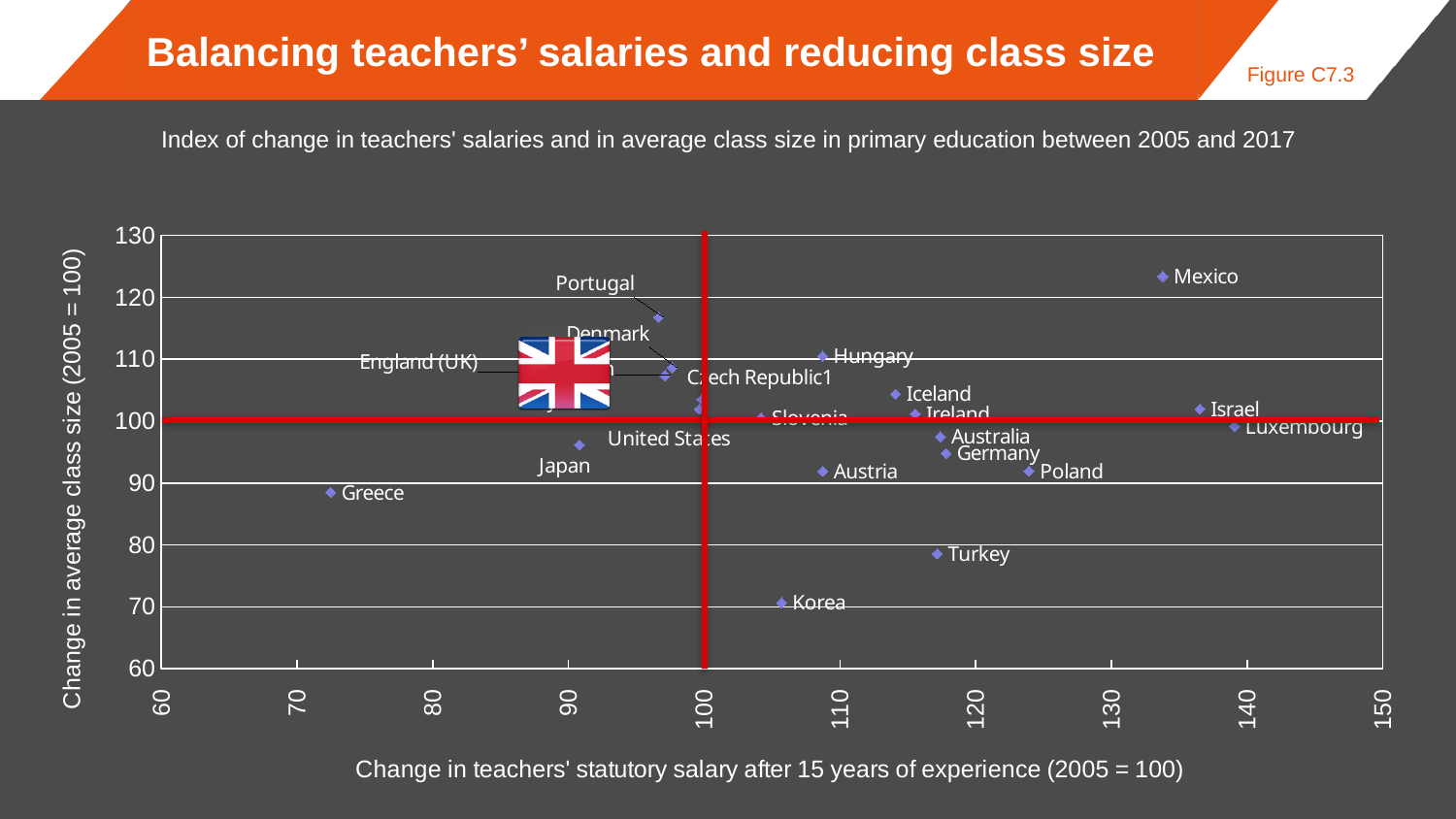
Which country has the lowest change in teachers' statutory salary? Greece Is the change in teachers' statutory salary for Turkey greater or less than 110? greater Which has a larger change in teachers' statutory salary, Greece or Turkey? Turkey Is the change in average class size for Mexico greater or less than 120? greater Which country has the lowest change in average class size? Korea Is the change in average class size for Korea greater or less than 80? less Which country has the highest change in average class size? Mexico Which has a larger change in average class size, Hungary or Austria? Hungary What is the title of the horizontal axis? Change in teachers' statutory salary after 15 years of experience (2005 = 100) What kind of chart is shown on the slide? scatter chart